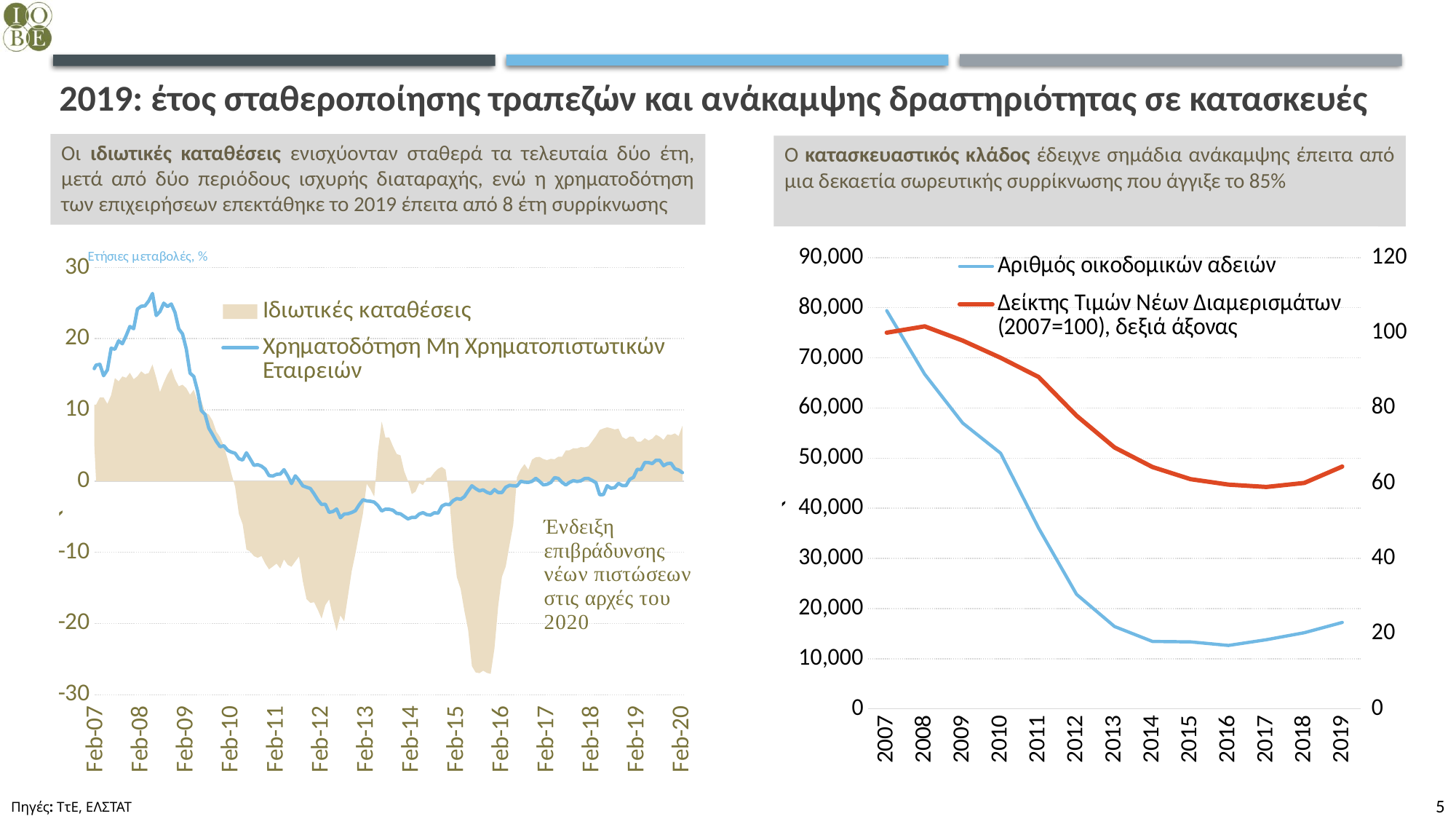
How many series does the legend of the left-hand chart list? 2 In the right-hand chart, is the value for Αριθμός οικοδομικών αδειών in 2019 greater or less than 20,000? less In the right-hand chart, is the value for Αριθμός οικοδομικών αδειών in 2012 greater or less than 30,000? less In the right-hand chart, which year has the highest value for Αριθμός οικοδομικών αδειών? 2007 How many years are labelled on the x axis of the right-hand chart? 13 In the right-hand chart, does Αριθμός οικοδομικών αδειών rise or fall from 2007 to 2014? fall In the right-hand chart, is the value for Αριθμός οικοδομικών αδειών in 2007 greater or less than 70,000? greater In the right-hand chart, which series is plotted against the right axis according to the legend? Δείκτης Τιμών Νέων Διαμερισμάτων (2007=100) What kind of chart is the right-hand chart (Αριθμός οικοδομικών αδειών)? line chart How many series does the legend of the right-hand chart list? 2